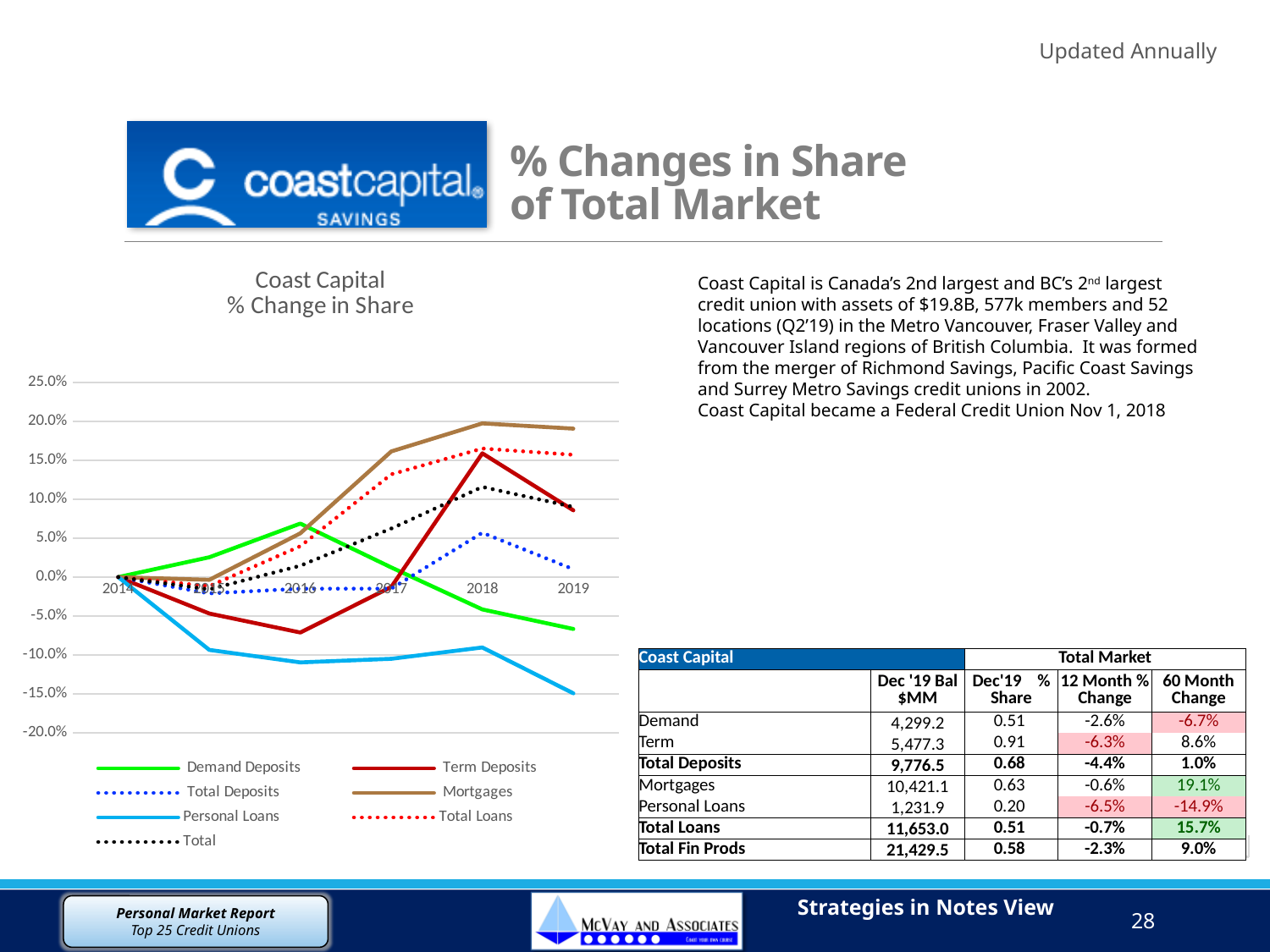
In 2018, which is larger: Mortgages or Term Deposits? Mortgages Is the value for Personal Loans in 2016 greater or less than -10.0%? less Is the value for Mortgages in 2018 greater or less than 15.0%? greater Does the Mortgages line rise or fall from 2014 to 2018? rise Which series is drawn with a green solid line in the chart? Demand Deposits Which series has the lowest value in 2019? Personal Loans Is the value for Demand Deposits in 2016 greater or less than 5.0%? greater How many series does the chart legend list? 7 What is the title of the chart? Coast Capital % Change in Share Which series has the highest value in 2019? Mortgages What kind of chart is shown on the slide? line chart How many years are plotted along the x axis of the chart? 6